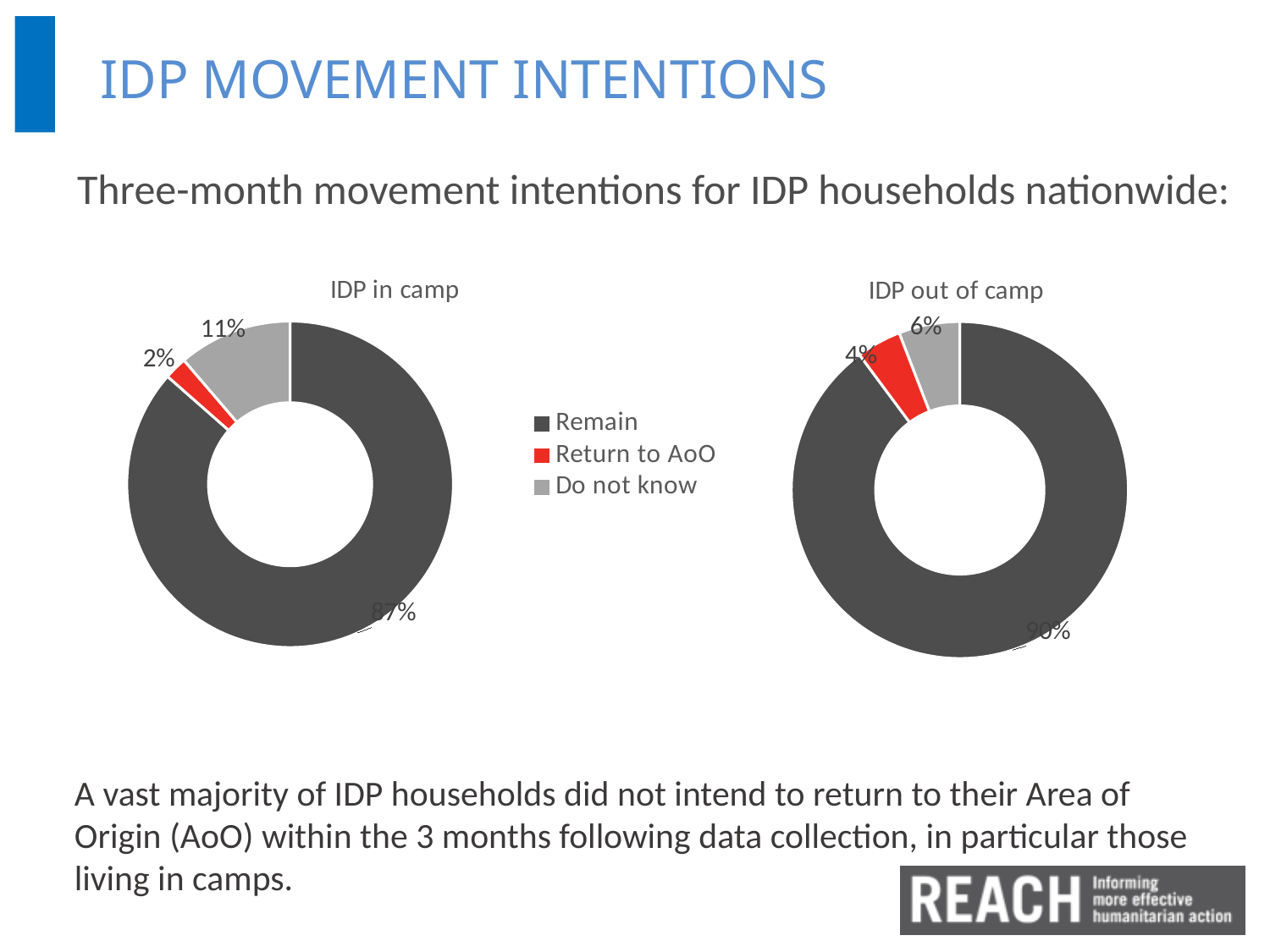
In the 'IDP out of camp' chart, what share of households do not know their intentions? 6% What is the difference between the 'Do not know' share in the 'IDP in camp' chart and in the 'IDP out of camp' chart? 5% In the 'IDP out of camp' chart, which category has the smallest share? Return to AoO In the 'IDP in camp' chart, what share of households intend to return to AoO? 2% In the 'IDP out of camp' chart, what share of households intend to remain? 90% In the 'IDP out of camp' chart, what share of households intend to return to AoO? 4% In the 'IDP in camp' chart, what share of households intend to remain? 87% Which chart shows a larger share for 'Return to AoO', 'IDP in camp' or 'IDP out of camp'? IDP out of camp What type of chart is used for 'IDP in camp'? Pie chart (donut) In the 'IDP in camp' chart, what share of households do not know their intentions? 11% In the 'IDP in camp' chart, which category has the largest share? Remain How many categories does the legend list for the charts? 3